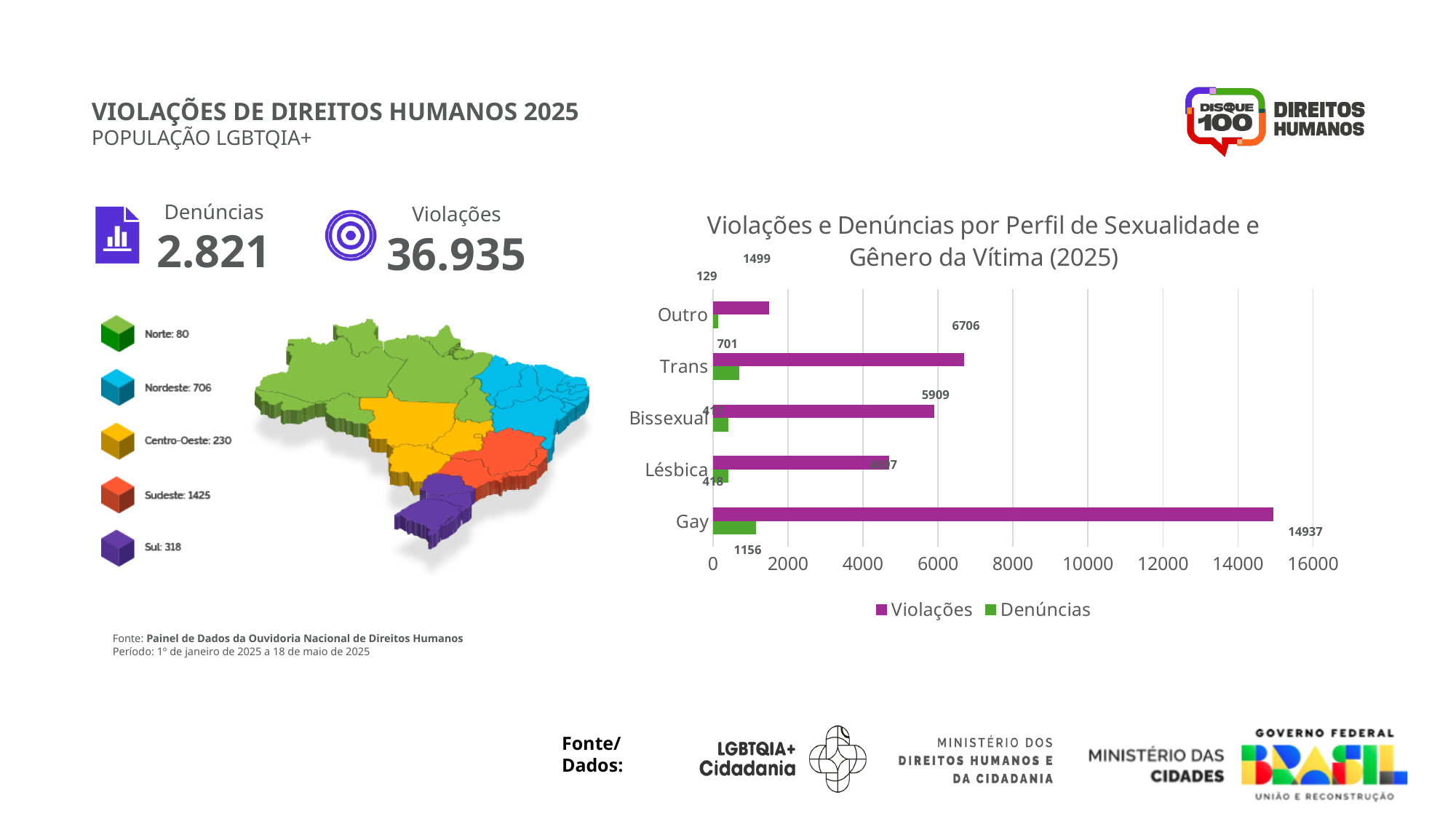
In the chart 'Violações e Denúncias por Perfil de Sexualidade e Gênero da Vítima (2025)', what is the Denúncias value for Outro? 129 How many categories are shown in the chart 'Violações e Denúncias por Perfil de Sexualidade e Gênero da Vítima (2025)'? 5 In the chart 'Violações e Denúncias por Perfil de Sexualidade e Gênero da Vítima (2025)', what is the difference between the Violações and Denúncias values for Gay? 13781 In the chart 'Violações e Denúncias por Perfil de Sexualidade e Gênero da Vítima (2025)', what is the Violações value for Trans? 6706 How many series does the legend of the chart 'Violações e Denúncias por Perfil de Sexualidade e Gênero da Vítima (2025)' list? 2 In the chart 'Violações e Denúncias por Perfil de Sexualidade e Gênero da Vítima (2025)', what is the Violações value for Gay? 14937 In the chart 'Violações e Denúncias por Perfil de Sexualidade e Gênero da Vítima (2025)', what is the Denúncias value for Gay? 1156 In the chart 'Violações e Denúncias por Perfil de Sexualidade e Gênero da Vítima (2025)', which category has the highest Violações value? Gay In the chart 'Violações e Denúncias por Perfil de Sexualidade e Gênero da Vítima (2025)', which has a larger Violações value, Trans or Bissexual? Trans In the chart 'Violações e Denúncias por Perfil de Sexualidade e Gênero da Vítima (2025)', is the Violações value for Lésbica greater or less than 4000? greater In the chart 'Violações e Denúncias por Perfil de Sexualidade e Gênero da Vítima (2025)', what is the difference between the Violações values for Trans and Bissexual? 797 In the chart 'Violações e Denúncias por Perfil de Sexualidade e Gênero da Vítima (2025)', which category has the lowest Violações value? Outro